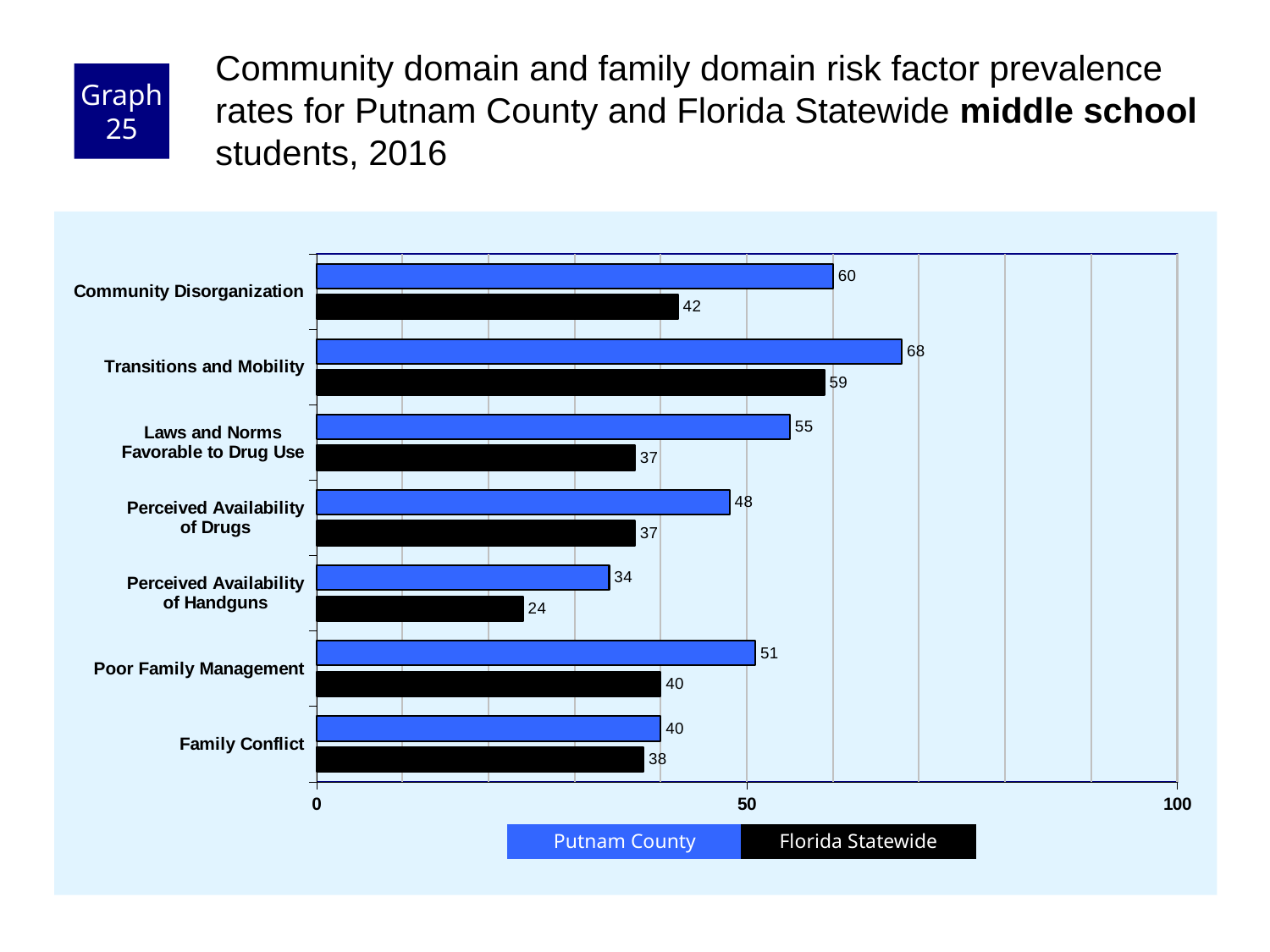
What is the Florida Statewide value for Perceived Availability of Handguns? 24 What kind of chart is shown on the slide? bar chart Which colour represents Florida Statewide in the chart? black Which risk factor has the lowest Florida Statewide value? Perceived Availability of Handguns What is the difference between the Putnam County and Florida Statewide values for Laws and Norms Favorable to Drug Use? 18 How many series does the legend list? 2 Is the Putnam County value for Perceived Availability of Drugs greater or less than 50? less How many risk factor categories are shown on the chart? 7 Which risk factor has the highest Putnam County value? Transitions and Mobility Which is larger for Poor Family Management: the Putnam County value or the Florida Statewide value? Putnam County What is the Putnam County value for Community Disorganization? 60 What is the Florida Statewide value for Transitions and Mobility? 59